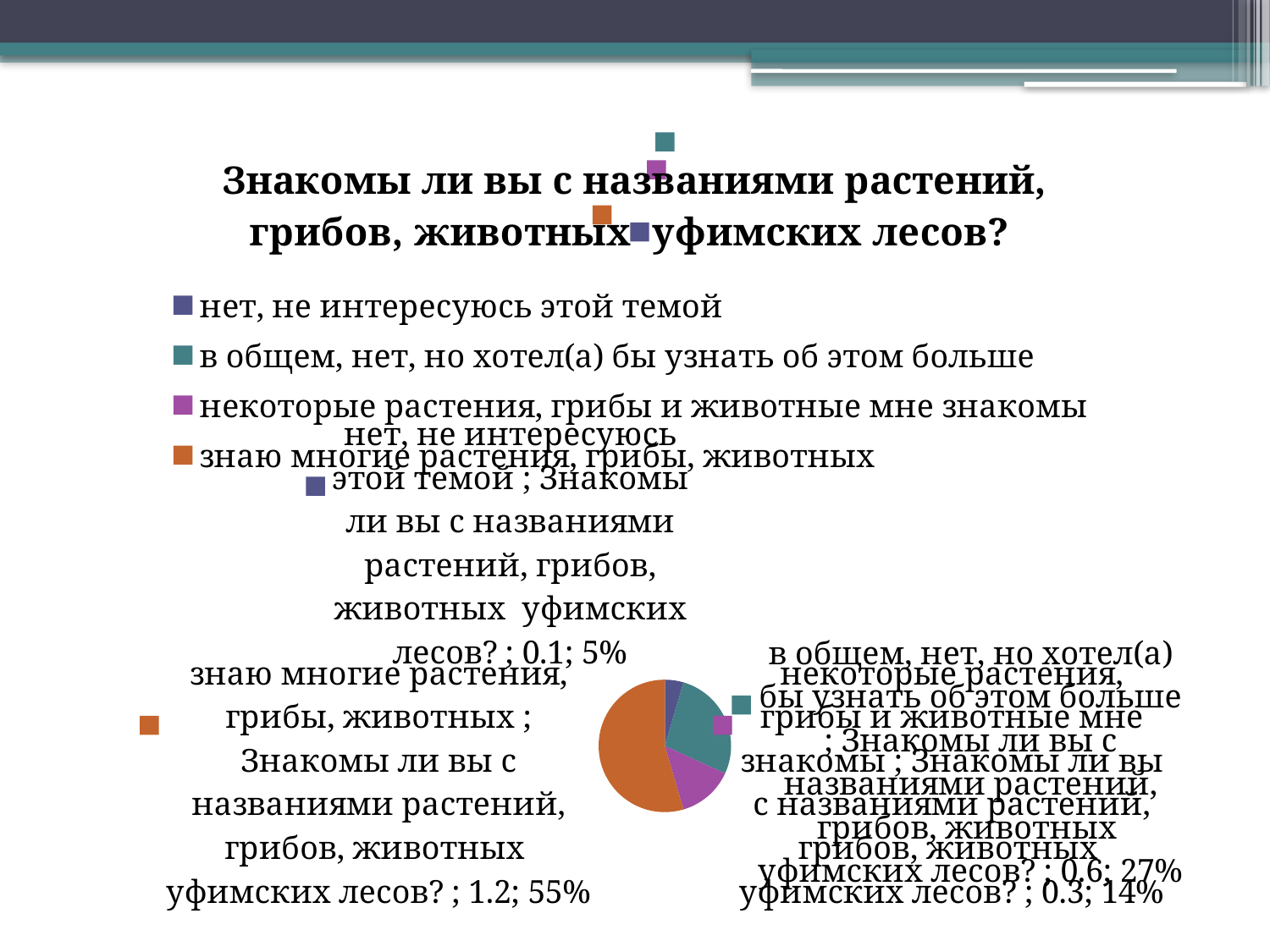
What percentage share does the slice 'нет, не интересуюсь этой темой' have? 5% What value is printed for the slice 'знаю многие растения, грибы, животных'? 1.2 What percentage share does the slice 'некоторые растения, грибы и животные мне знакомы' have? 14% What value is printed for the slice 'в общем, нет, но хотел(а) бы узнать об этом больше'? 0.6 What percentage share does the slice 'в общем, нет, но хотел(а) бы узнать об этом больше' have? 27% Which category has the largest slice of the pie? знаю многие растения, грибы, животных Which category has the smallest slice of the pie? нет, не интересуюсь этой темой How many slices does the pie chart have? 4 What kind of chart is shown on the slide? pie chart How many entries does the legend of the pie chart list? 4 What is the difference in percentage points between the 'знаю многие растения, грибы, животных' slice and the 'в общем, нет, но хотел(а) бы узнать об этом больше' slice? 28%